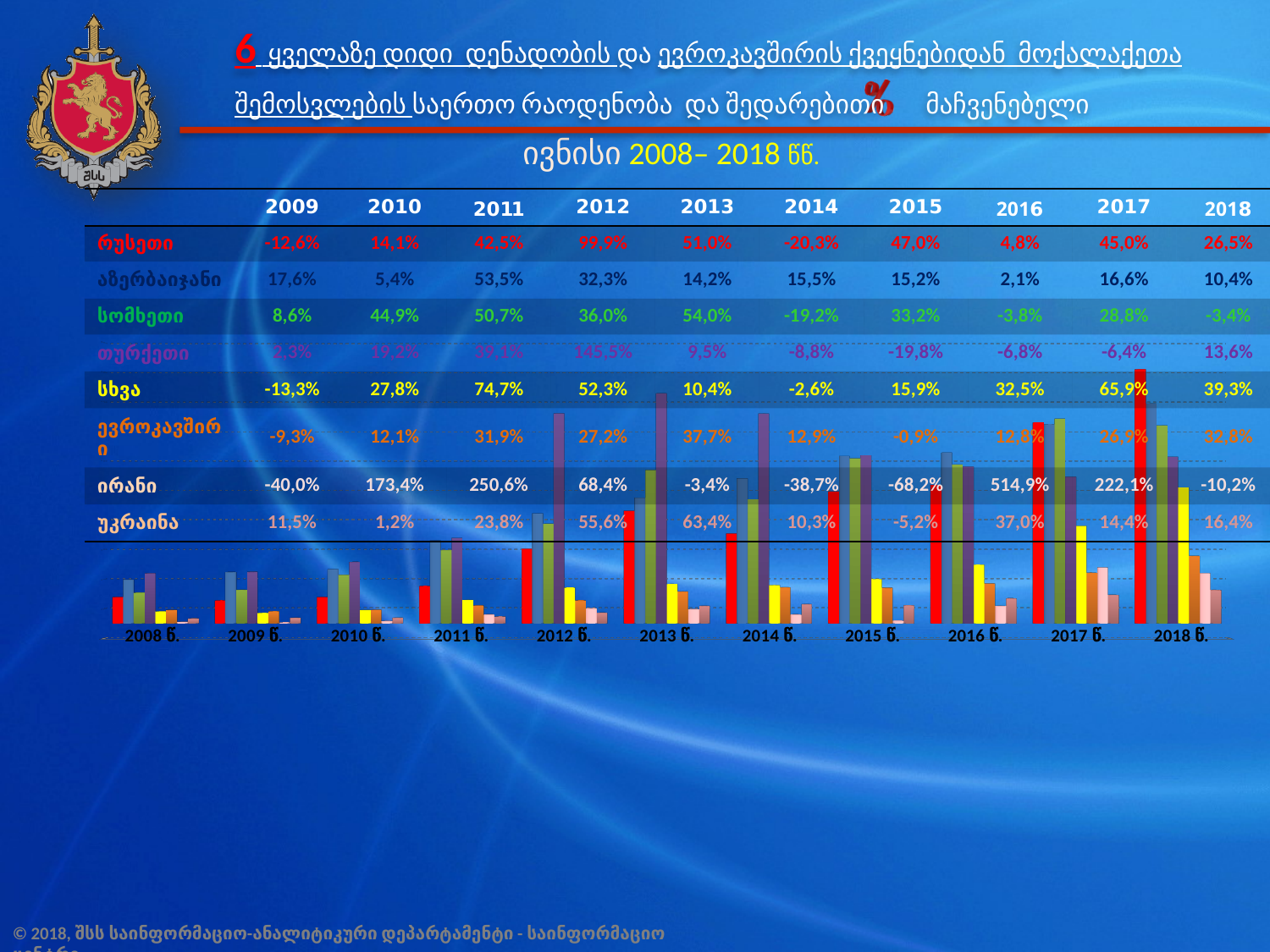
What kind of chart is shown at the bottom of the slide? bar chart In which year is the purple bar the tallest in the bar chart? 2013 წ. Does the bar chart display a legend? No Is the green bar taller in 2012 წ. or in 2010 წ.? 2012 წ. Is the red bar taller in 2018 წ. or in 2008 წ.? 2018 წ. What is the last category label on the x axis of the bar chart? 2018 წ. What is the first category label on the x axis of the bar chart? 2008 წ. In which year is the red bar the tallest in the bar chart? 2018 წ. Is the yellow bar taller in 2017 წ. or in 2009 წ.? 2017 წ. Which range of years does the slide title say the data covers? 2008– 2018 How many year categories are shown along the x axis of the bar chart? 11 In which year is the yellow bar the tallest in the bar chart? 2018 წ.